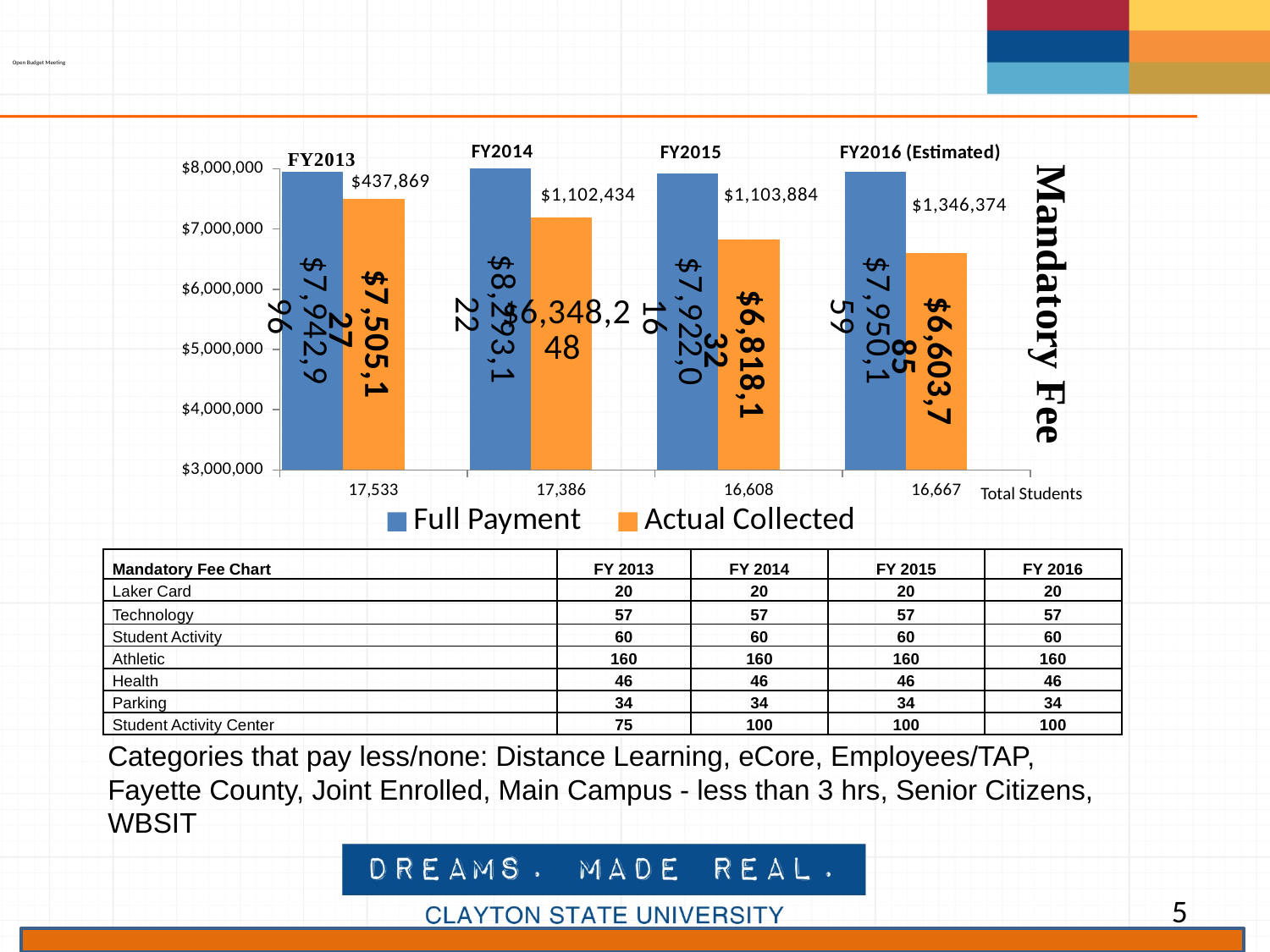
What gap value is labelled above the FY2013 bars? $437,869 Is the Actual Collected value for FY2016 (Estimated) greater or less than $7,000,000? less Do the Actual Collected values rise or fall from FY2013 to FY2016 (Estimated)? fall What are the two series named in the chart legend? Full Payment and Actual Collected What gap value is labelled above the FY2016 (Estimated) bars? $1,346,374 What kind of chart is shown on the slide? bar chart Which fiscal year has the highest Actual Collected bar? FY2013 How many series does the chart legend list? 2 What is the Total Students figure shown for FY2015? 16,608 What is the Total Students figure shown for FY2013? 17,533 How many fiscal years are plotted in the chart? 4 Which fiscal year has the lowest Actual Collected bar? FY2016 (Estimated)